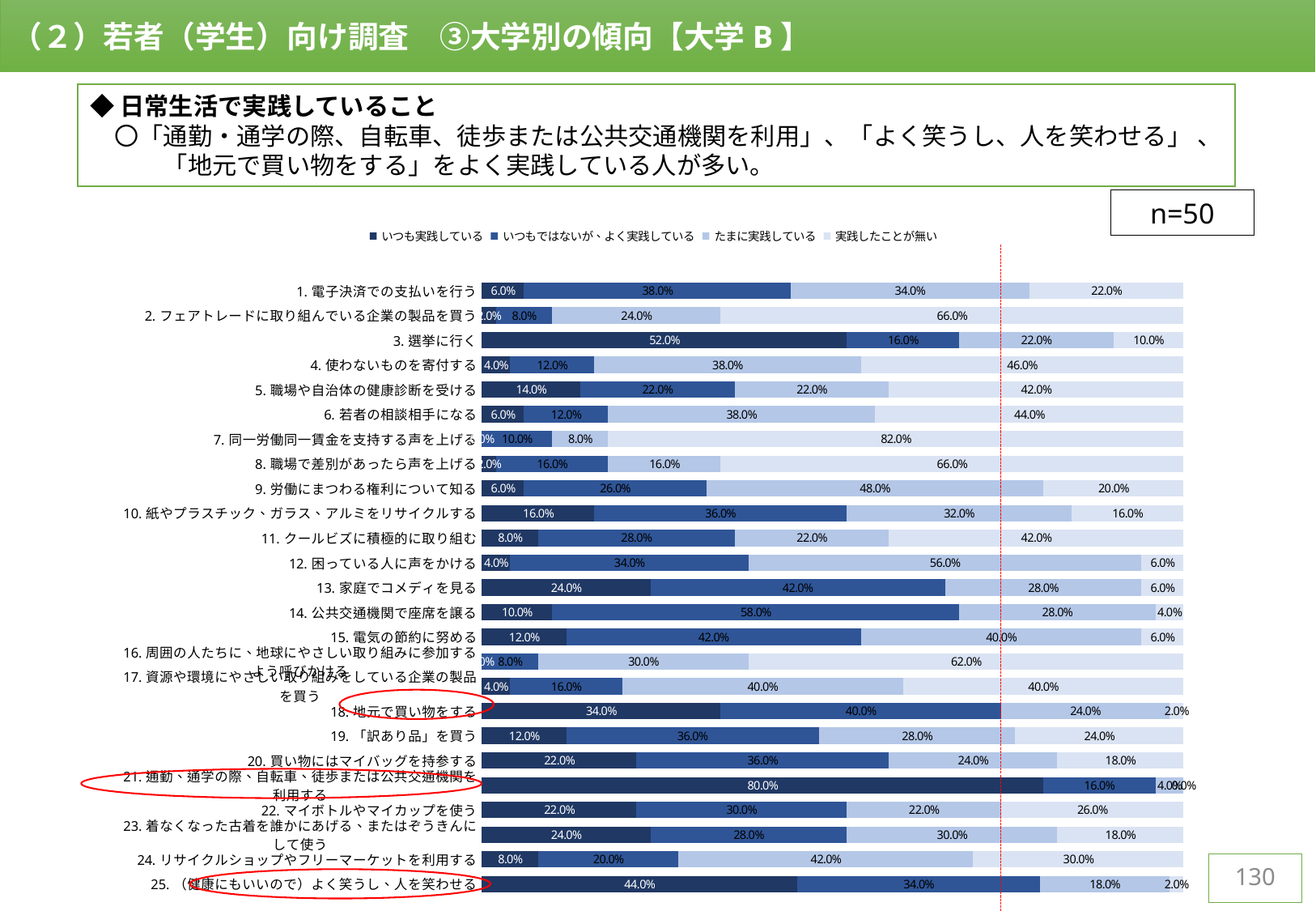
How many categories (items) are plotted in the chart? 25 Which item has the highest value for いつも実践している? 21. 通勤、通学の際、自転車、徒歩または公共交通機関を利用する Which has the larger いつも実践している value: item 25 (よく笑うし、人を笑わせる) or item 18 (地元で買い物をする)? 25. （健康にもいいので）よく笑うし、人を笑わせる What is the value of いつもではないが、よく実践している for item 14 (公共交通機関で座席を譲る)? 58.0% What is the value of 実践したことが無い for item 7 (同一労働同一賃金を支持する声を上げる)? 82.0% What kind of chart is shown on the slide? bar chart How many series does the legend list? 4 Which item has the highest value for 実践したことが無い? 7. 同一労働同一賃金を支持する声を上げる What is the difference between the いつも実践している values for item 21 (80.0%) and item 3 (52.0%)? 28.0% What sample size (n) is shown on the slide? n=50 What is the value of いつも実践している for item 21 (通勤、通学の際、自転車、徒歩または公共交通機関を利用する)? 80.0% What is the value of いつも実践している for item 3 (選挙に行く)? 52.0%